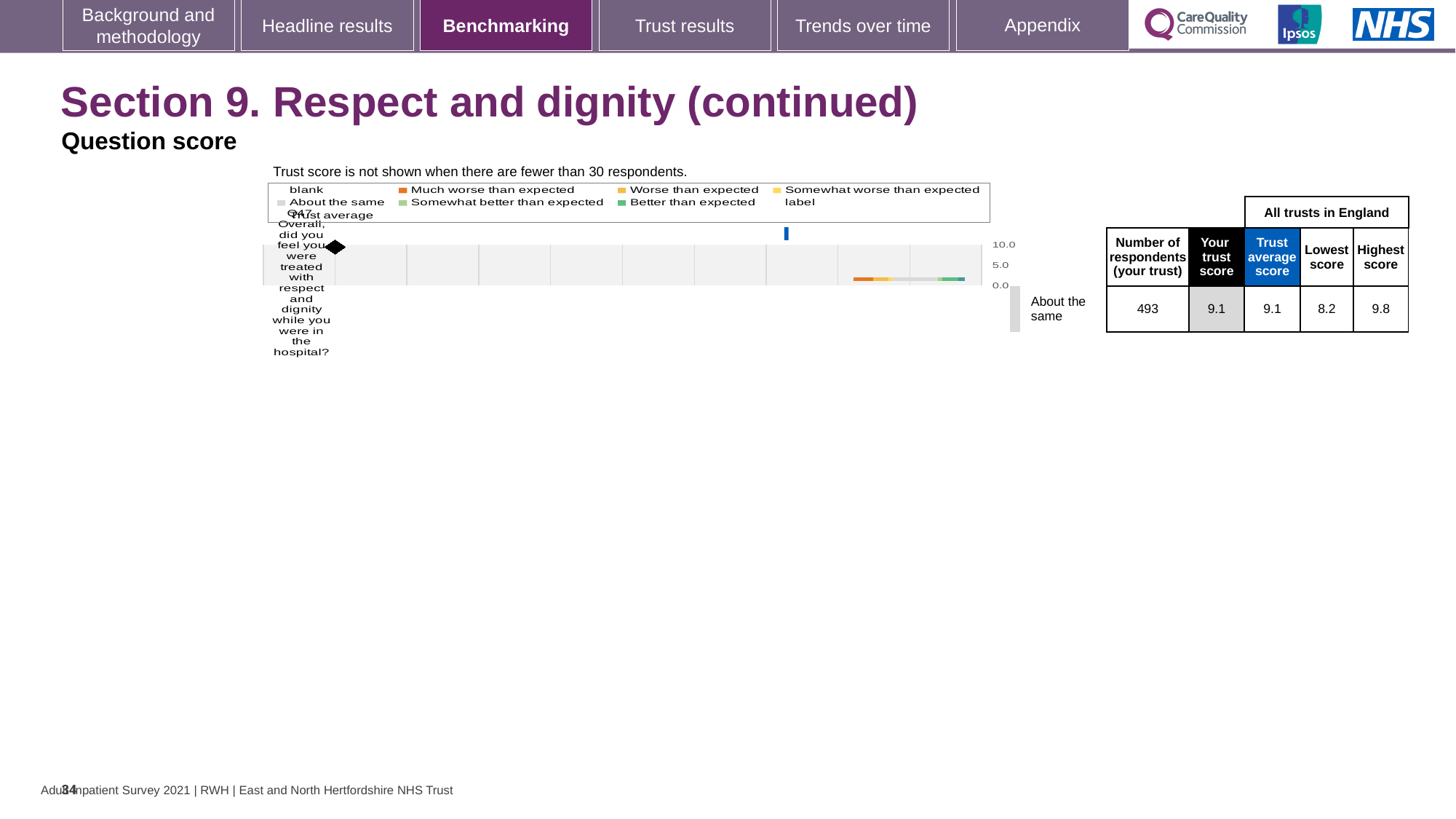
What is the difference between the highest score and the lowest score for Q47? 1.6 What kind of chart is used to show the benchmarking result for Q47? bar chart What is the highest tick value shown on the chart's score axis? 10.0 What is the lowest score among all trusts in England for Q47? 8.2 What is your trust score for Q47 (Overall, did you feel you were treated with respect and dignity while you were in the hospital?)? 9.1 Is your trust score for Q47 greater or less than 5.0 on the chart's axis? greater What is the trust average score for all trusts in England for Q47? 9.1 What is the difference between the highest score and your trust score for Q47? 0.7 What is the highest score among all trusts in England for Q47? 9.8 Is your trust score for Q47 higher, lower or the same as the trust average score? the same Which benchmarking category is your trust's result for Q47 placed in? About the same How many respondents from your trust are shown in the table for Q47? 493